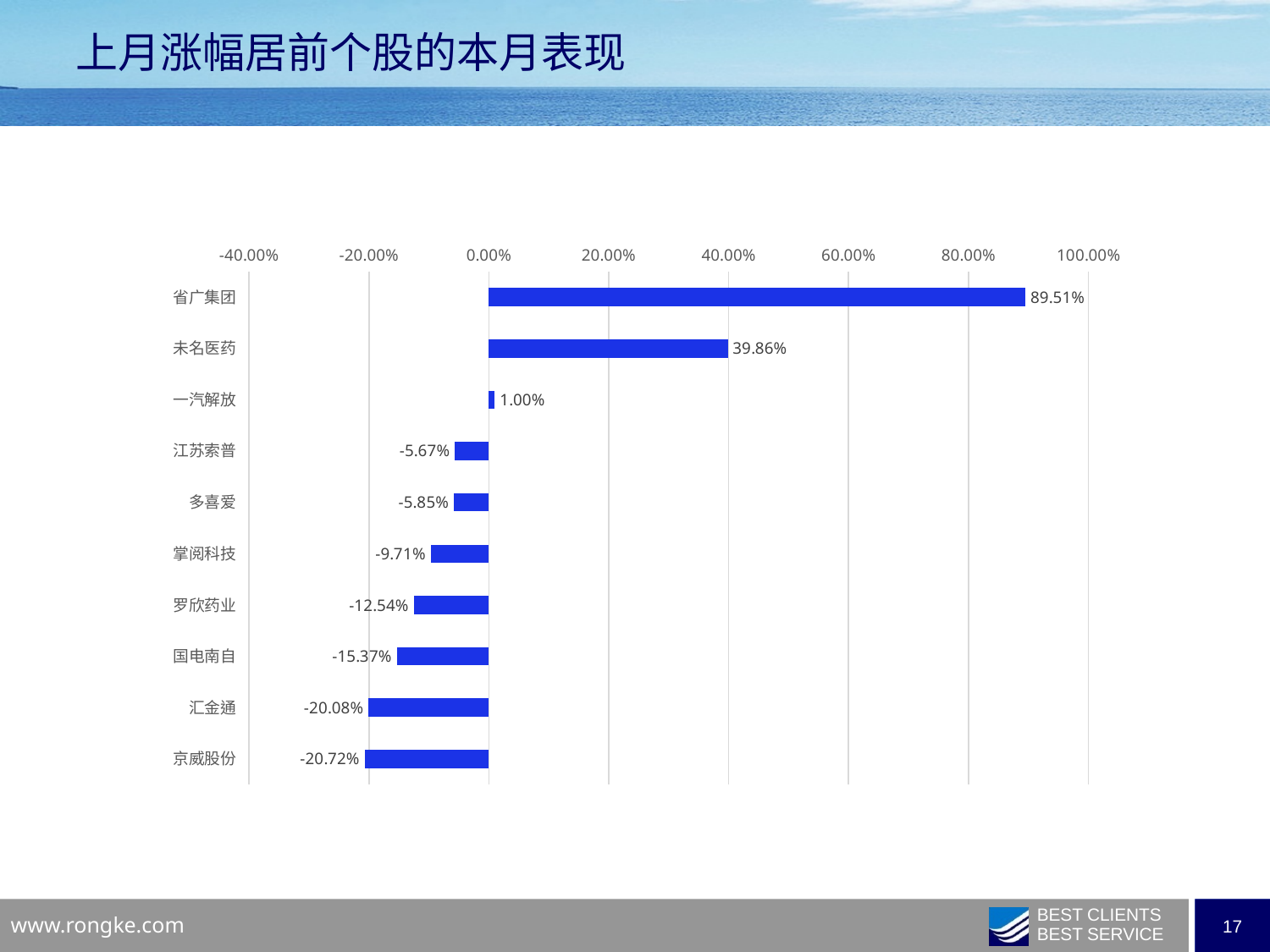
What is the value for 京威股份? -20.72% Which stock has the highest value? 省广集团 How many stocks are shown in the chart? 10 Which stock has the lowest value? 京威股份 What is the value for 未名医药? 39.86% What is the difference between the values for 省广集团 and 未名医药? 49.65% What is the title of the slide? 上月涨幅居前个股的本月表现 What is the value for 罗欣药业? -12.54% Which has a larger value, 国电南自 or 掌阅科技? 掌阅科技 What kind of chart is shown on the slide? bar chart Is the value for 汇金通 greater or less than -20.00%? less What is the value for 省广集团? 89.51%